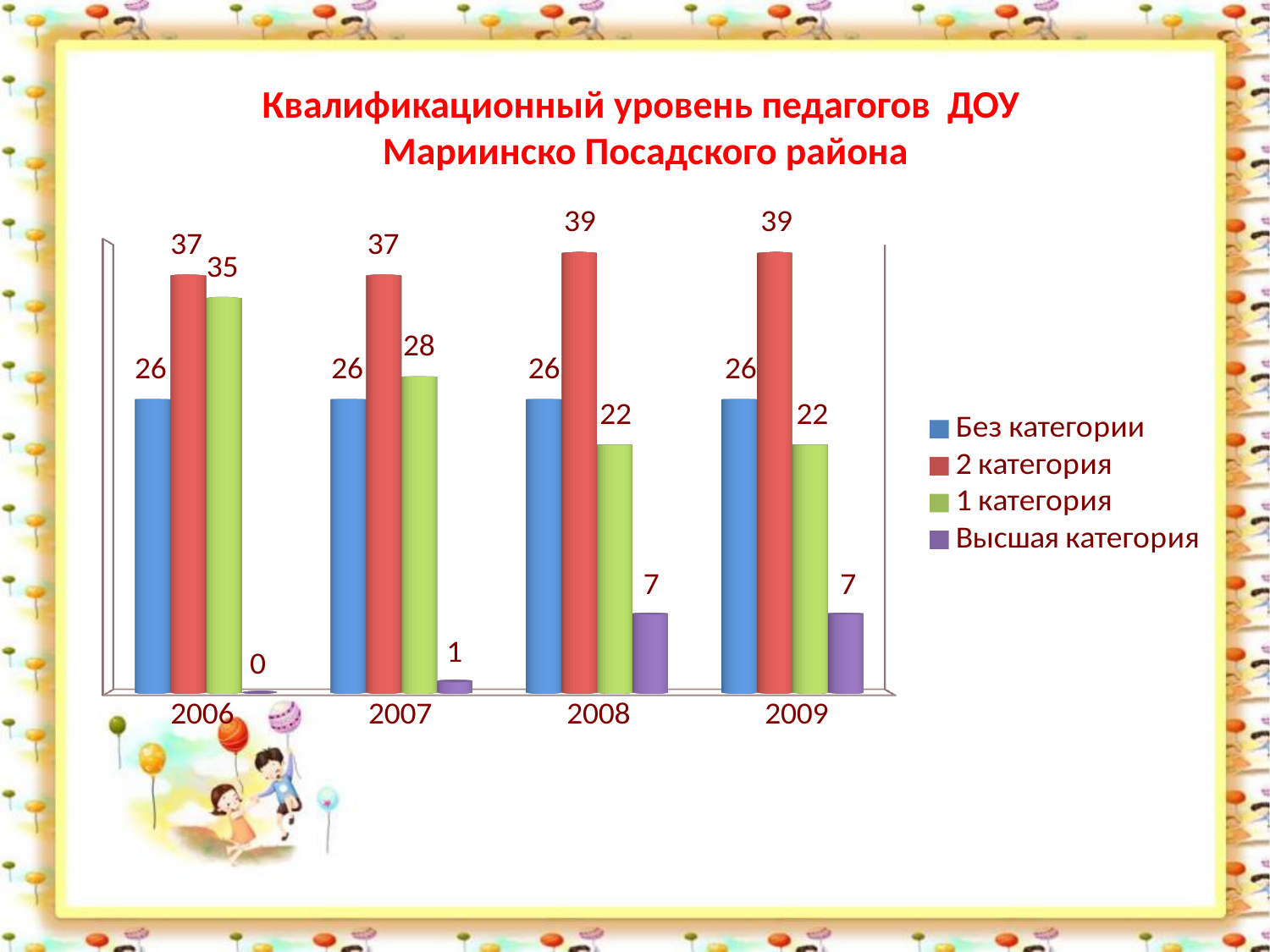
What is the value for "1 категория" in 2006? 35 What is the value for "Высшая категория" in 2007? 1 Which is larger in 2007: the value for "2 категория" or the value for "1 категория"? 2 категория What is the difference between the "2 категория" value and the "1 категория" value in 2009? 17 How many series does the legend list? 4 What is the value for "2 категория" in 2008? 39 In which year is the value for "1 категория" highest? 2006 What kind of chart is shown on the slide? Bar chart What is the value for "Без категории" in 2009? 26 In which year is the value for "Высшая категория" lowest? 2006 How many years are shown on the x axis? 4 Does the value for "1 категория" rise or fall from 2006 to 2009? Fall